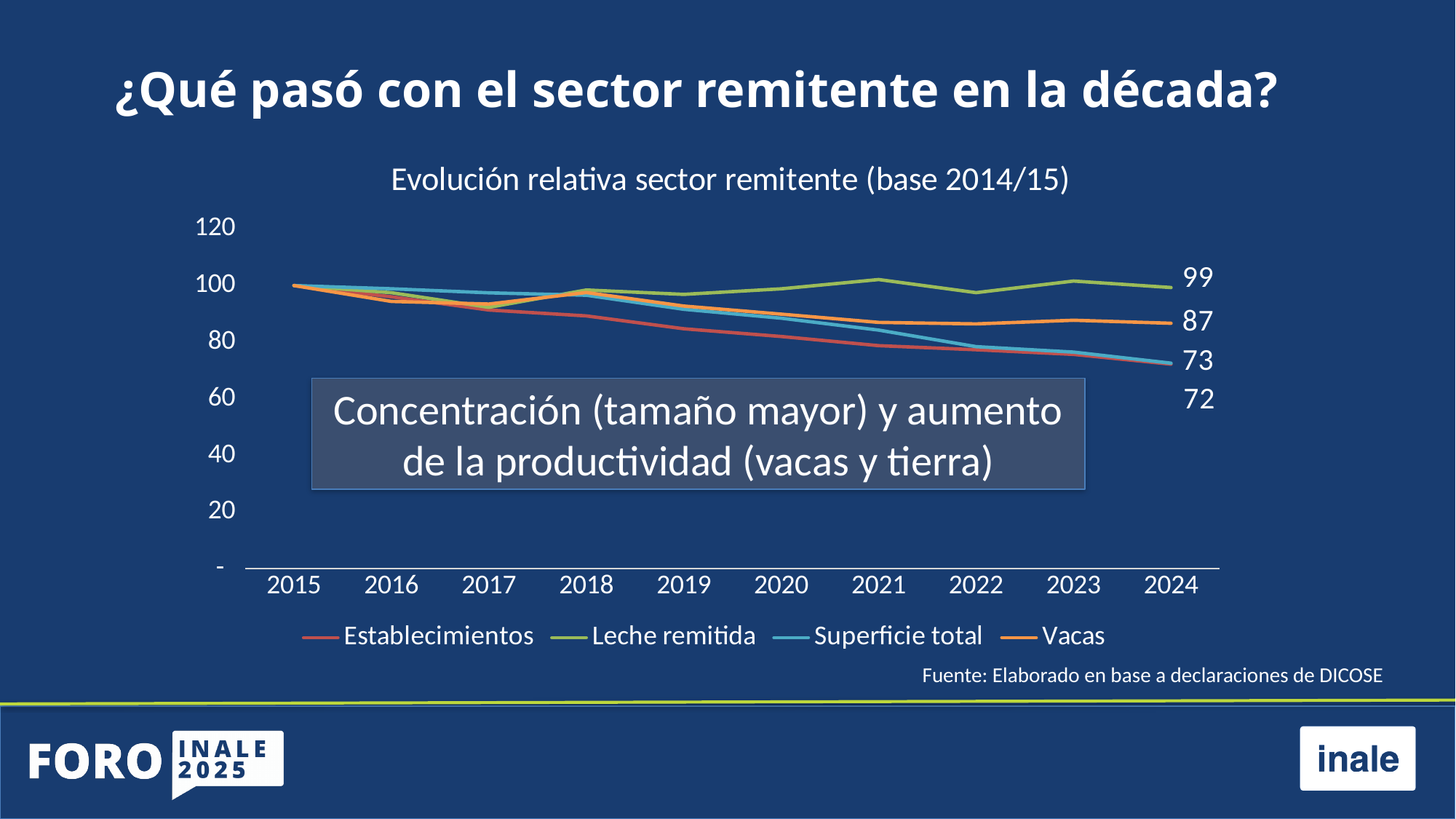
In 2024, which is larger: Leche remitida or Vacas? Leche remitida What is the title of the chart? Evolución relativa sector remitente (base 2014/15) How many series does the legend list? 4 What is the value for Leche remitida in 2024? 99 What kind of chart is shown on the slide? line chart Is the value for Establecimientos in 2019 greater or less than 100? less How many years are shown on the x axis? 10 What is the value for Vacas in 2024? 87 Does the Establecimientos series rise or fall from 2015 to 2024? fall Is the value for Vacas in 2022 greater or less than 100? less What is the difference between the 2024 values of Leche remitida and Vacas? 12 Which series has the highest value in 2024? Leche remitida